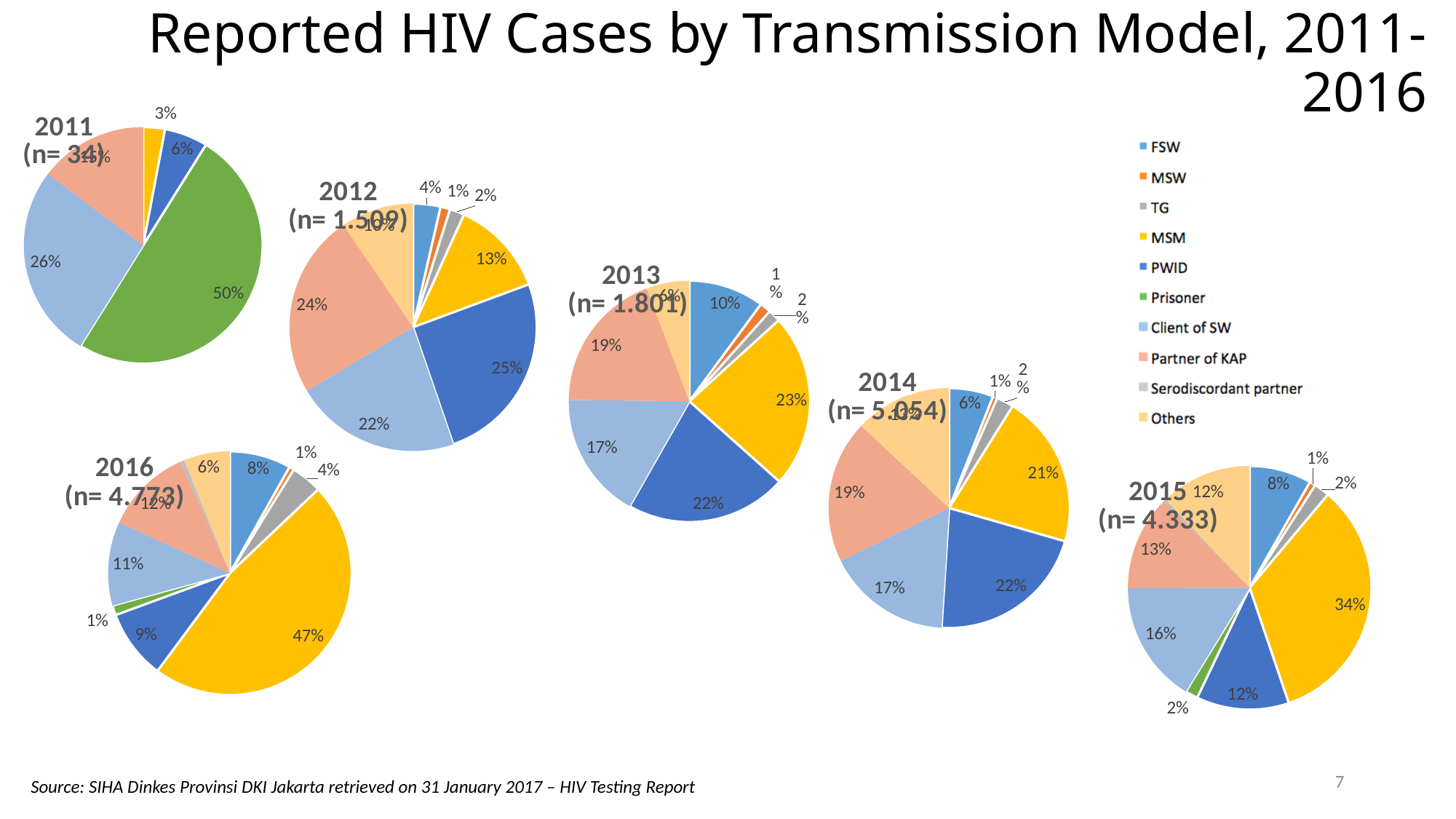
How many pie charts are shown on the slide? 6 Does the MSM share rise or fall from the 2015 pie chart to the 2016 pie chart? Rises How many transmission categories does the legend list? 10 In the 2012 pie chart, what share of reported HIV cases is attributed to PWID? 25% In the 2013 pie chart, which transmission category has the largest share? MSM What kind of chart is used to show the reported HIV cases for each year on this slide? Pie chart In the 2016 pie chart, what share of reported HIV cases is attributed to MSM? 47% In the 2011 pie chart, what share of reported HIV cases is attributed to Prisoner? 50% What is the n value shown for the 2015 pie chart? 4.333 In the 2015 pie chart, what share of reported HIV cases is attributed to MSM? 34% In the 2015 pie chart, which is larger: the share for Client of SW or the share for Partner of KAP? Client of SW In the 2016 pie chart, how many percentage points larger is the MSM share than the PWID share? 38 percentage points